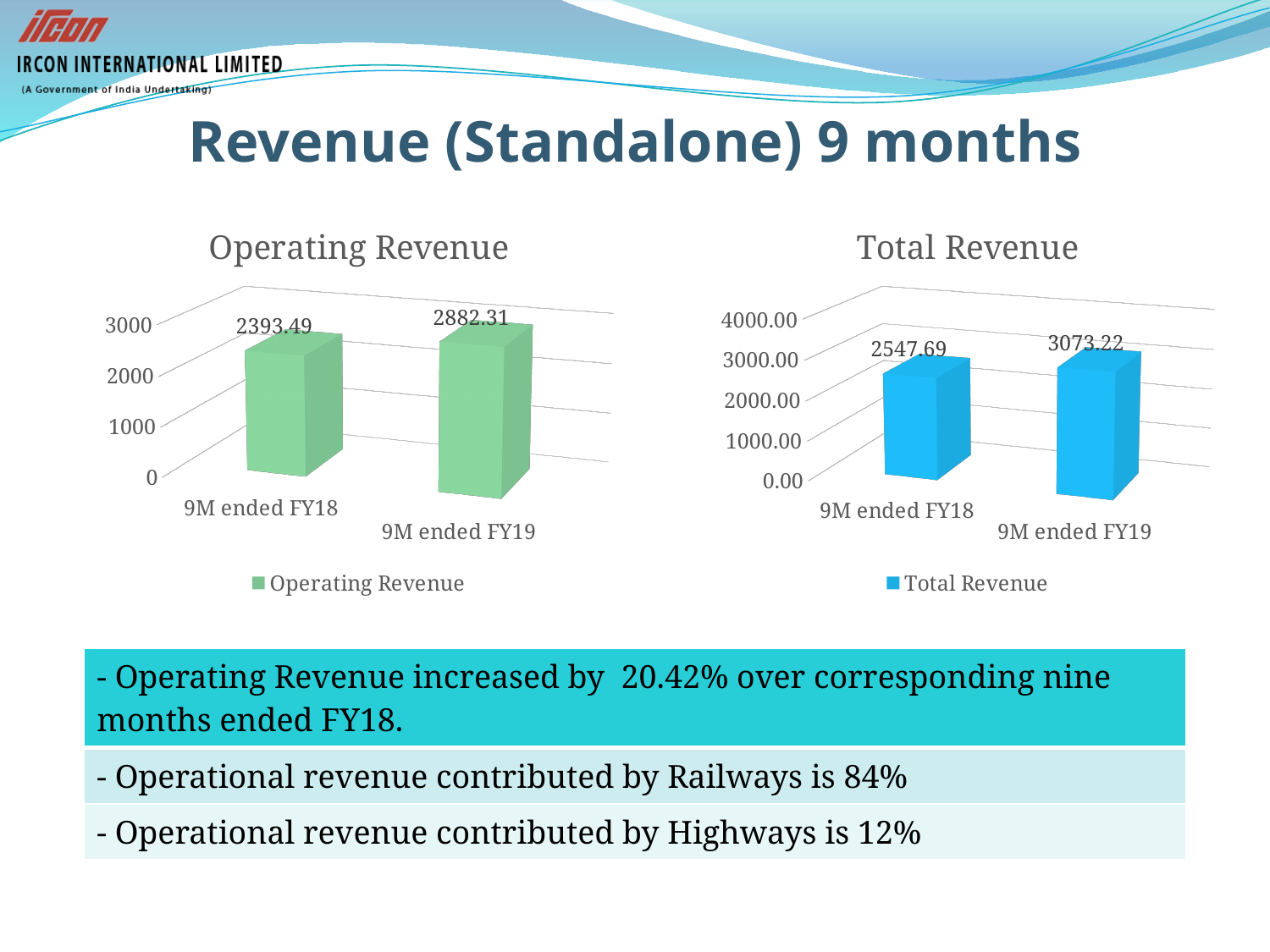
In the Operating Revenue chart, what is the value for 9M ended FY19? 2882.31 In the Operating Revenue chart, what is the value for 9M ended FY18? 2393.49 In the Total Revenue chart, what is the value for 9M ended FY19? 3073.22 In the Operating Revenue chart, do the values rise or fall from 9M ended FY18 to 9M ended FY19? Rise In the Total Revenue chart, is the value for 9M ended FY19 greater or less than 3000.00? greater In the Operating Revenue chart, what is the difference between the 9M ended FY19 and 9M ended FY18 values? 488.82 What kind of chart is the Total Revenue chart? Bar chart In the Total Revenue chart, what is the difference between the 9M ended FY19 and 9M ended FY18 values? 525.53 In the Total Revenue chart, what is the value for 9M ended FY18? 2547.69 In the Total Revenue chart, which period has the lower value? 9M ended FY18 In the Operating Revenue chart, which period has the higher value? 9M ended FY19 How many categories are shown in the Operating Revenue chart? 2